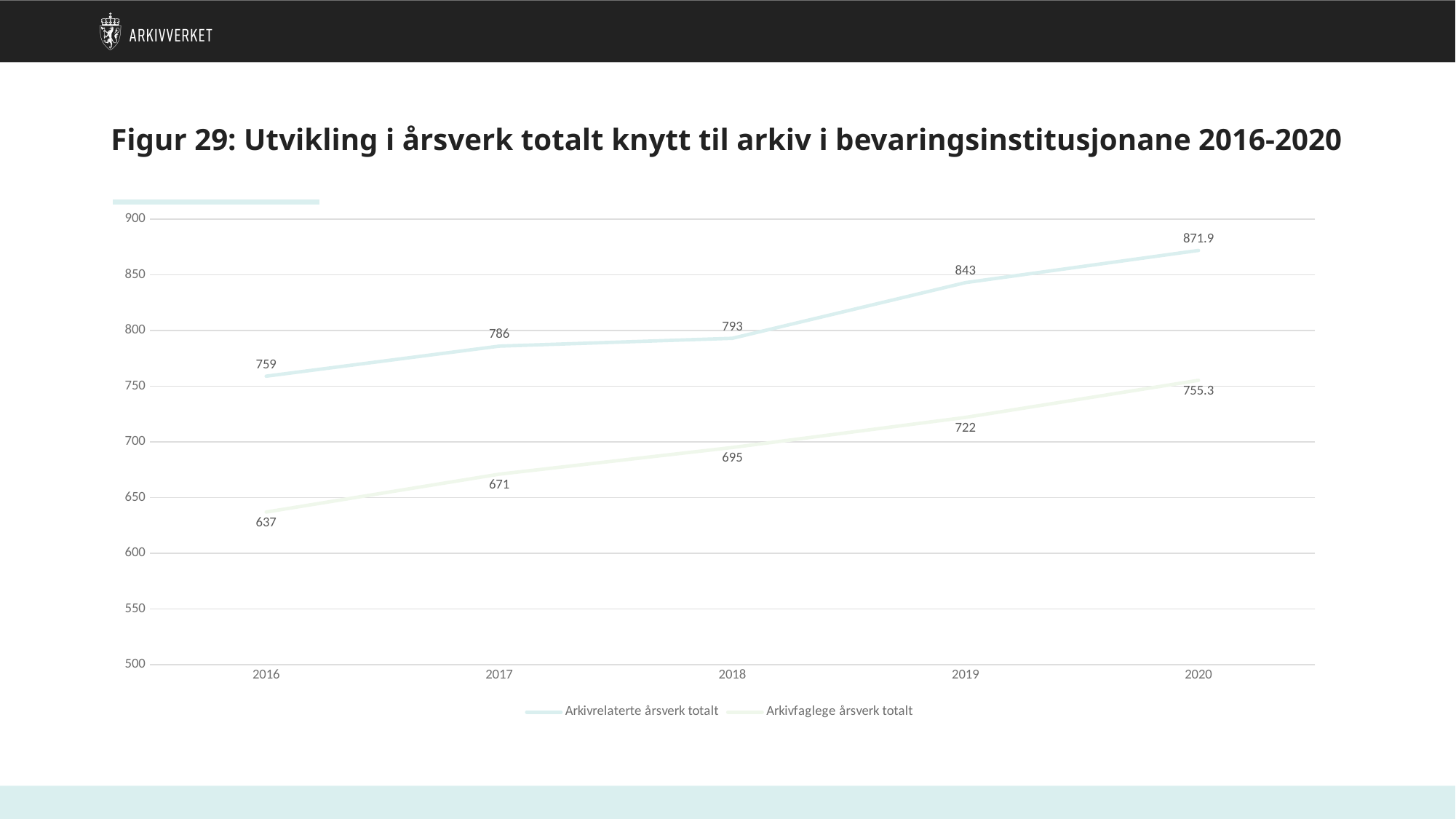
Is the value for Arkivfaglege årsverk totalt in 2018 greater or less than 700? less In which year is Arkivfaglege årsverk totalt lowest? 2016 What is the value for Arkivrelaterte årsverk totalt in 2018? 793 What kind of chart is shown on the slide? line chart By how much did Arkivrelaterte årsverk totalt increase from 2016 to 2020? 112.9 How many series does the legend list? 2 What is the value for Arkivfaglege årsverk totalt in 2020? 755.3 How many years are shown on the x axis? 5 What is the value for Arkivfaglege årsverk totalt in 2016? 637 In which year is Arkivrelaterte årsverk totalt highest? 2020 Which is larger in 2017: Arkivrelaterte årsverk totalt or Arkivfaglege årsverk totalt? Arkivrelaterte årsverk totalt What is the difference between Arkivrelaterte årsverk totalt and Arkivfaglege årsverk totalt in 2019? 121